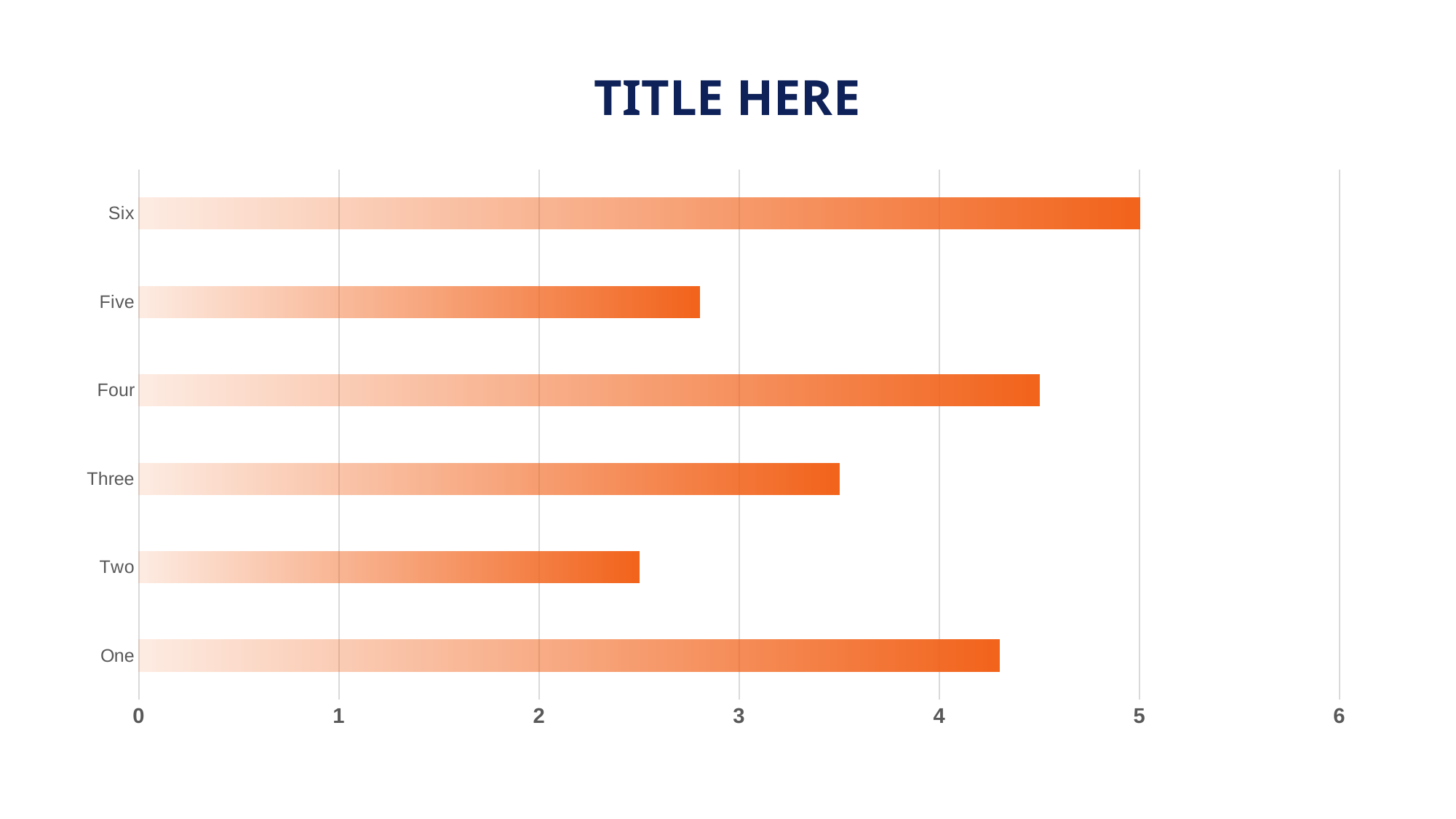
Which has the larger value, Four or Three? Four Is the value for Two greater or less than 3? less Is the value for Five greater or less than 3? less What is the value for Six? 5 Is the value for Three greater or less than 3? greater Which category has the lowest value? Two Which category has the highest value? Six What is the title of the chart? TITLE HERE What kind of chart is shown on the slide? bar chart Which has the larger value, Two or Five? Five How many categories are plotted in the chart? 6